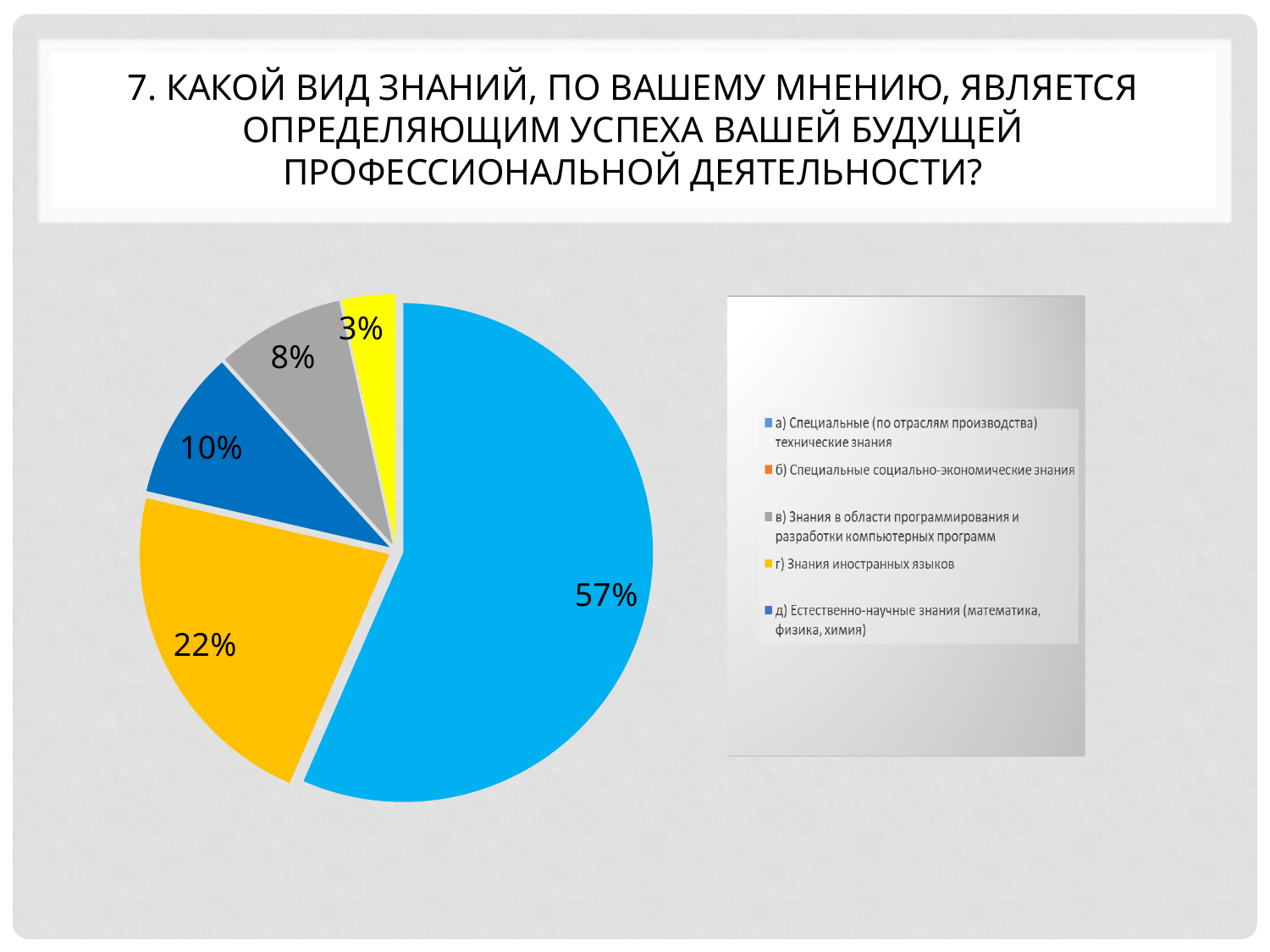
What share of the pie is labelled for 'а) Специальные (по отраслям производства) технические знания'? 57% What kind of chart is shown on the slide? pie chart How many entries does the legend list? 5 What is the value of the smallest slice in the pie chart? 3% What is the value of the dark blue slice, 'д) Естественно-научные знания (математика, физика, химия)'? 10% What is the value of the largest slice in the pie chart? 57% What is the difference between the largest slice (57%) and the second largest slice (22%)? 35 percentage points What is the difference between the dark blue slice (10%) and the gray slice (8%)? 2 percentage points What is the value of the gray slice, 'в) Знания в области программирования и разработки компьютерных программ'? 8% What colour is the largest slice of the pie chart? light blue How many slices does the pie chart have? 5 Which slice is larger: the dark blue slice or the gray slice? the dark blue slice (10%)